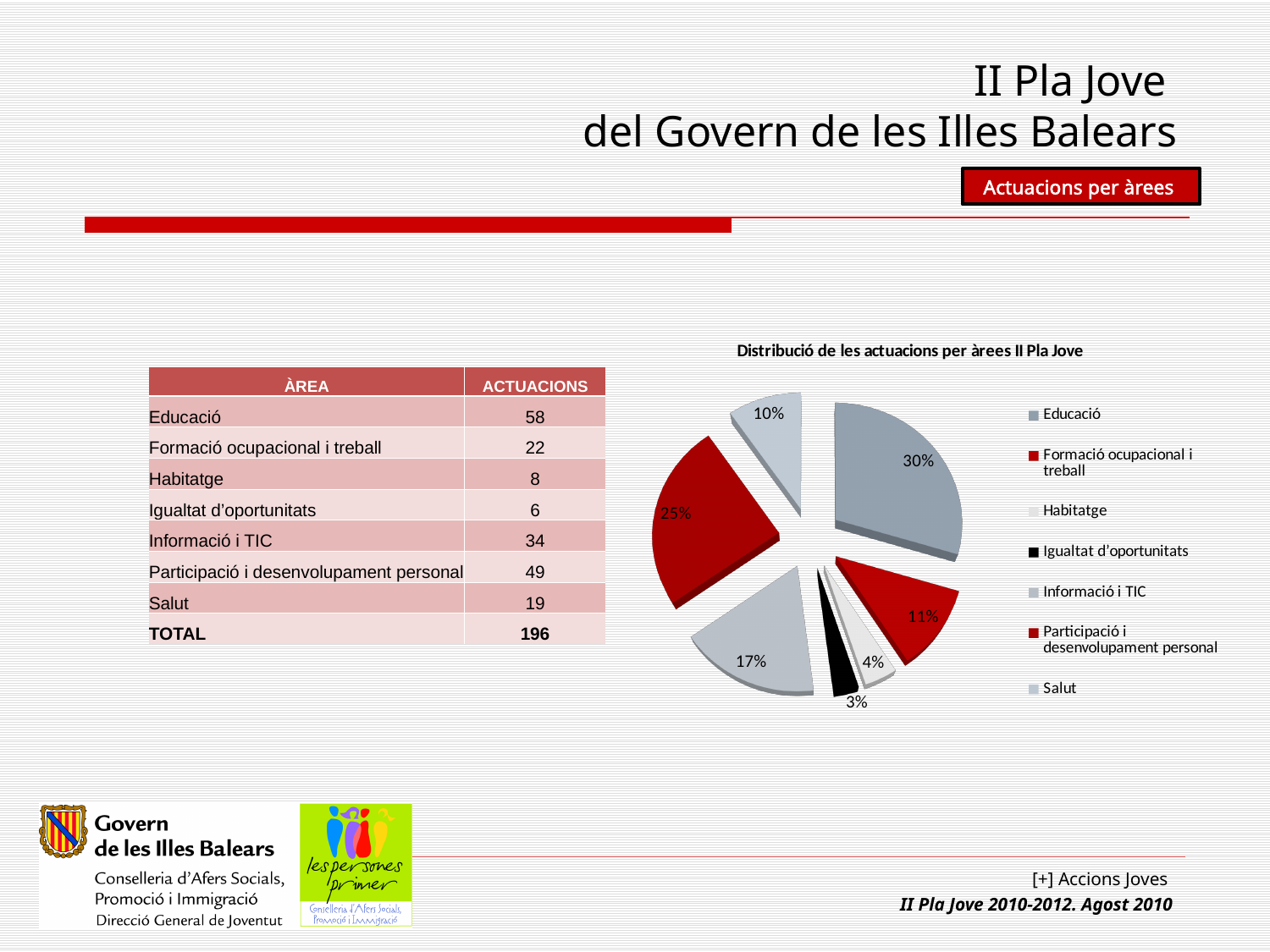
What percentage is shown for Salut? 10% Which slice is larger, Formació ocupacional i treball or Informació i TIC? Informació i TIC What is the difference in percentage points between the Educació slice and the Participació i desenvolupament personal slice? 5 percentage points What percentage is shown for Habitatge? 4% Which area has the smallest slice of the pie? Igualtat d'oportunitats What share of the pie does Educació represent? 30% What is the title of the chart? Distribució de les actuacions per àrees II Pla Jove What kind of chart is shown on the slide? Pie chart Which area has the largest slice of the pie? Educació How many slices does the pie chart have? 7 What percentage is shown for Informació i TIC? 17% What share of the pie does Participació i desenvolupament personal represent? 25%